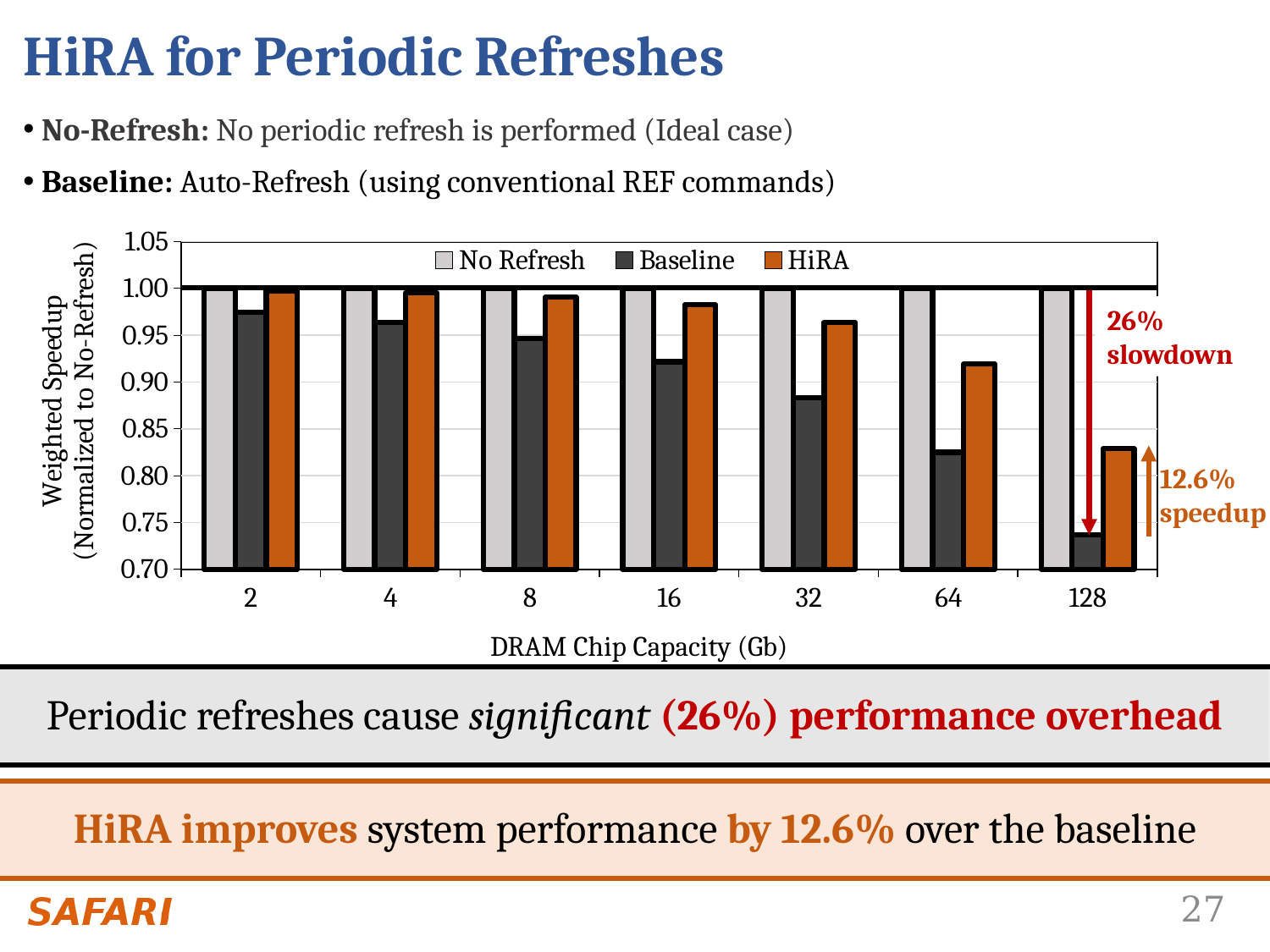
Is the HiRA value at 64 Gb greater or less than 0.90? greater How many series does the chart's legend list? 3 What is the No Refresh value at 128 Gb DRAM chip capacity? 1.00 How many DRAM chip capacity categories are shown on the x axis? 7 Is the Baseline value at 128 Gb greater or less than 0.75? less Does the Baseline weighted speedup rise or fall as DRAM chip capacity increases? fall What is the x-axis title of the chart? DRAM Chip Capacity (Gb) What kind of chart is shown on the slide? bar chart At which DRAM chip capacity is the Baseline value lowest? 128 Is the Baseline value at 64 Gb greater or less than 0.85? less At 128 Gb, which is larger: the Baseline value or the HiRA value? HiRA